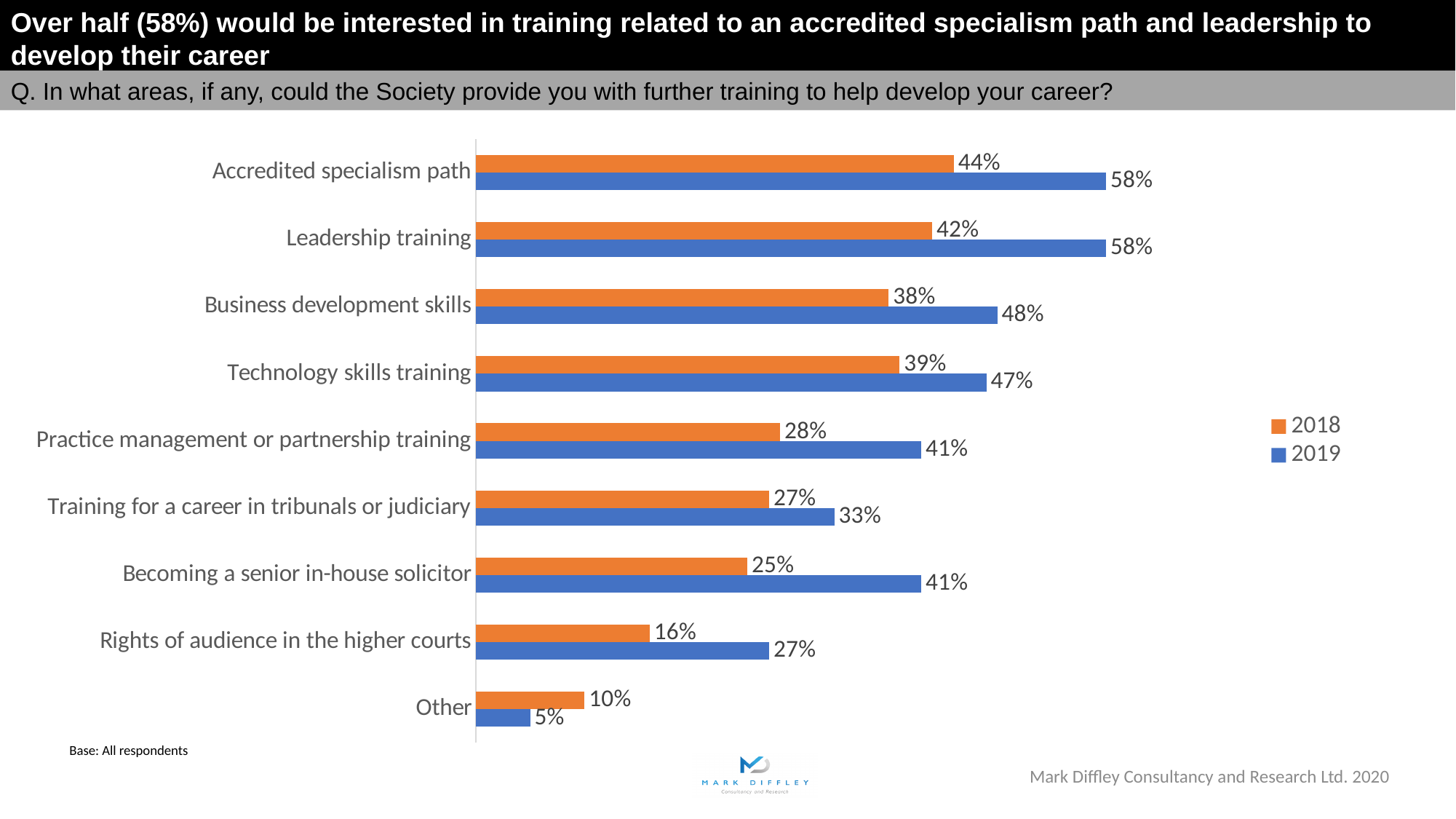
How many series does the legend list? 2 Which colour represents the 2019 series in the legend? Blue How many categories are shown on the chart? 9 Which category has the highest 2018 value? Accredited specialism path Which is larger for Other: the 2018 value or the 2019 value? 2018 Which is larger: the 2019 value for Technology skills training or the 2019 value for Training for a career in tribunals or judiciary? Technology skills training What kind of chart is shown on the slide? Bar chart Which category has the lowest 2019 value? Other What is the 2018 value for Practice management or partnership training? 28% What is the difference between the 2019 and 2018 values for Becoming a senior in-house solicitor? 16 percentage points What is the 2019 value for Business development skills? 48% What is the 2019 value for Rights of audience in the higher courts? 27%